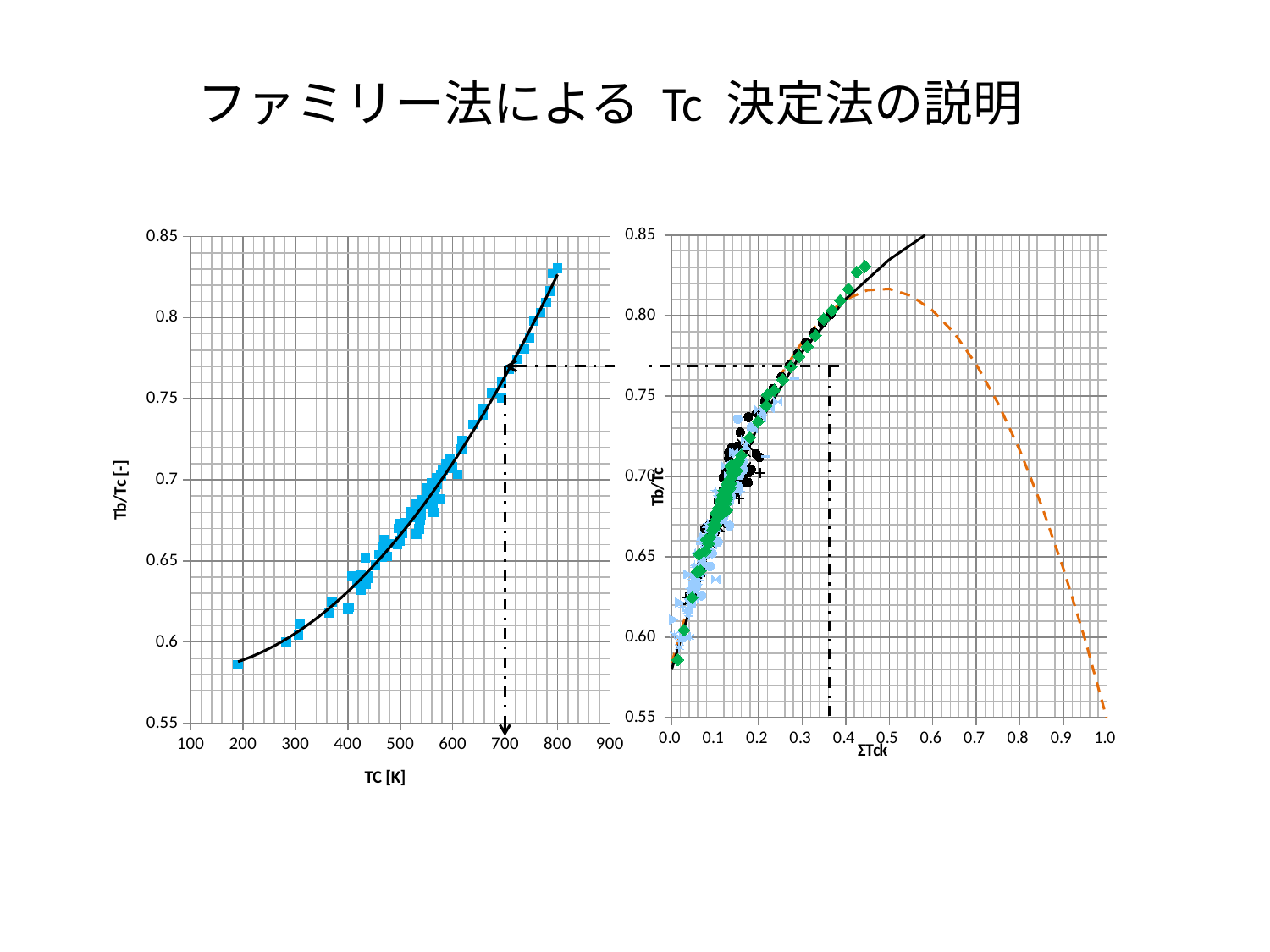
In the right chart, is the peak of the orange dashed curve greater or less than 0.75? greater What is the x-axis label of the left chart? TC [K] In the left chart, is the Tb/Tc value of the leftmost data point (near TC = 200 K) greater or less than 0.6? less In the left chart, is the Tb/Tc value of the data point at about TC = 800 K greater or less than 0.8? greater What kind of chart is the left chart (Tb/Tc versus TC [K])? scatter chart In the right chart, do the plotted data points rise or fall as ΣTck increases from 0.0 to 0.4? rise In the left chart, do the Tb/Tc values rise or fall as TC increases along the x axis? rise What is the x-axis label of the right chart? ΣTck What kind of chart is the right chart (Tb/Tc versus ΣTck)? scatter chart